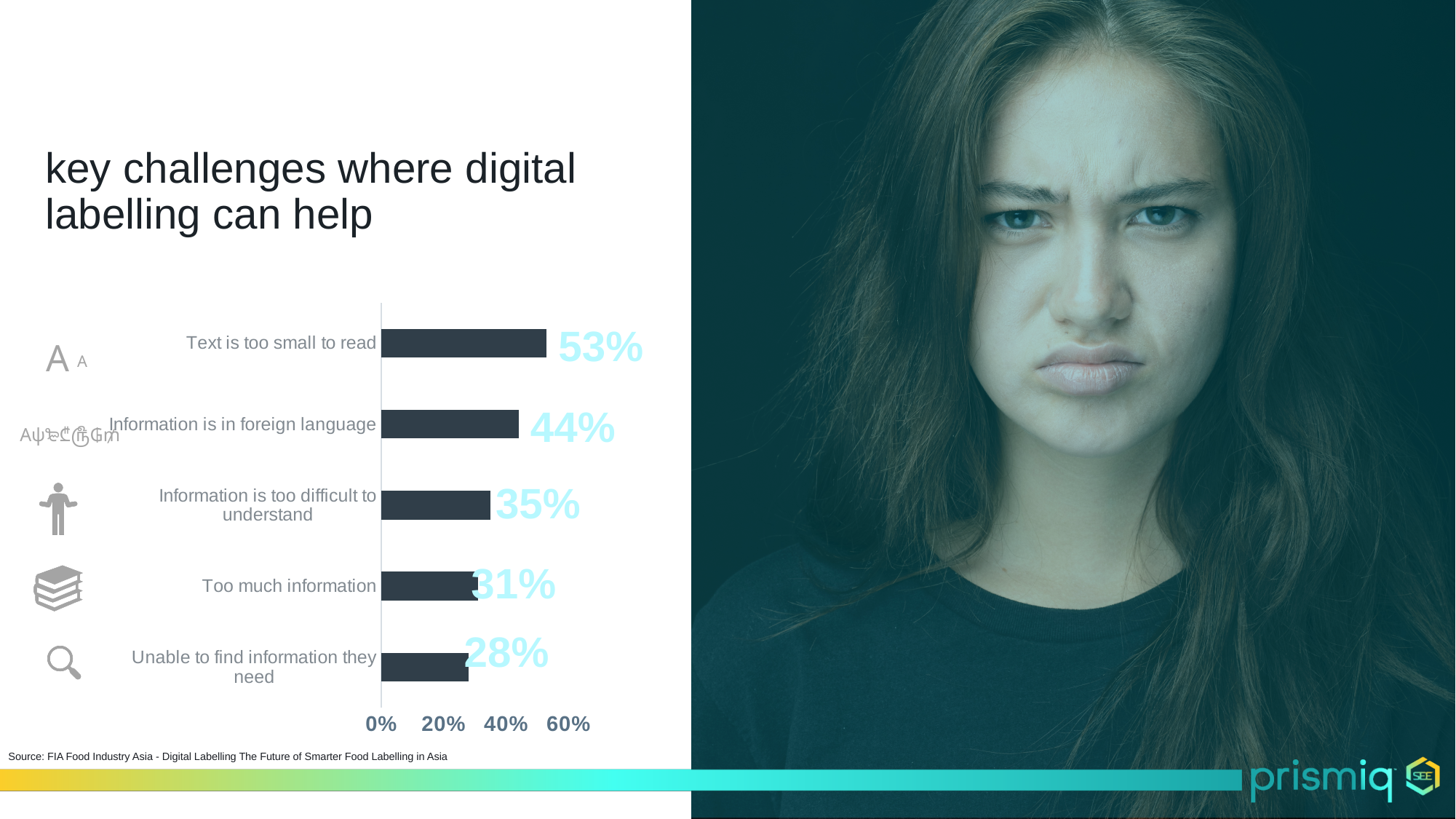
What is the value for 'Unable to find information they need'? 28% What percentage of respondents said text is too small to read? 53% What is the value for 'Information is in foreign language'? 44% What kind of chart is shown on the slide? Bar chart Which is larger: 'Too much information' or 'Information is too difficult to understand'? Information is too difficult to understand How many challenges are plotted in the chart? 5 Which challenge has the highest value? Text is too small to read What is the value for 'Too much information'? 31% What is the difference between 'Text is too small to read' and 'Information is in foreign language'? 9% What is the title of the slide containing the chart? key challenges where digital labelling can help What is the value for 'Information is too difficult to understand'? 35% Which challenge has the lowest value? Unable to find information they need